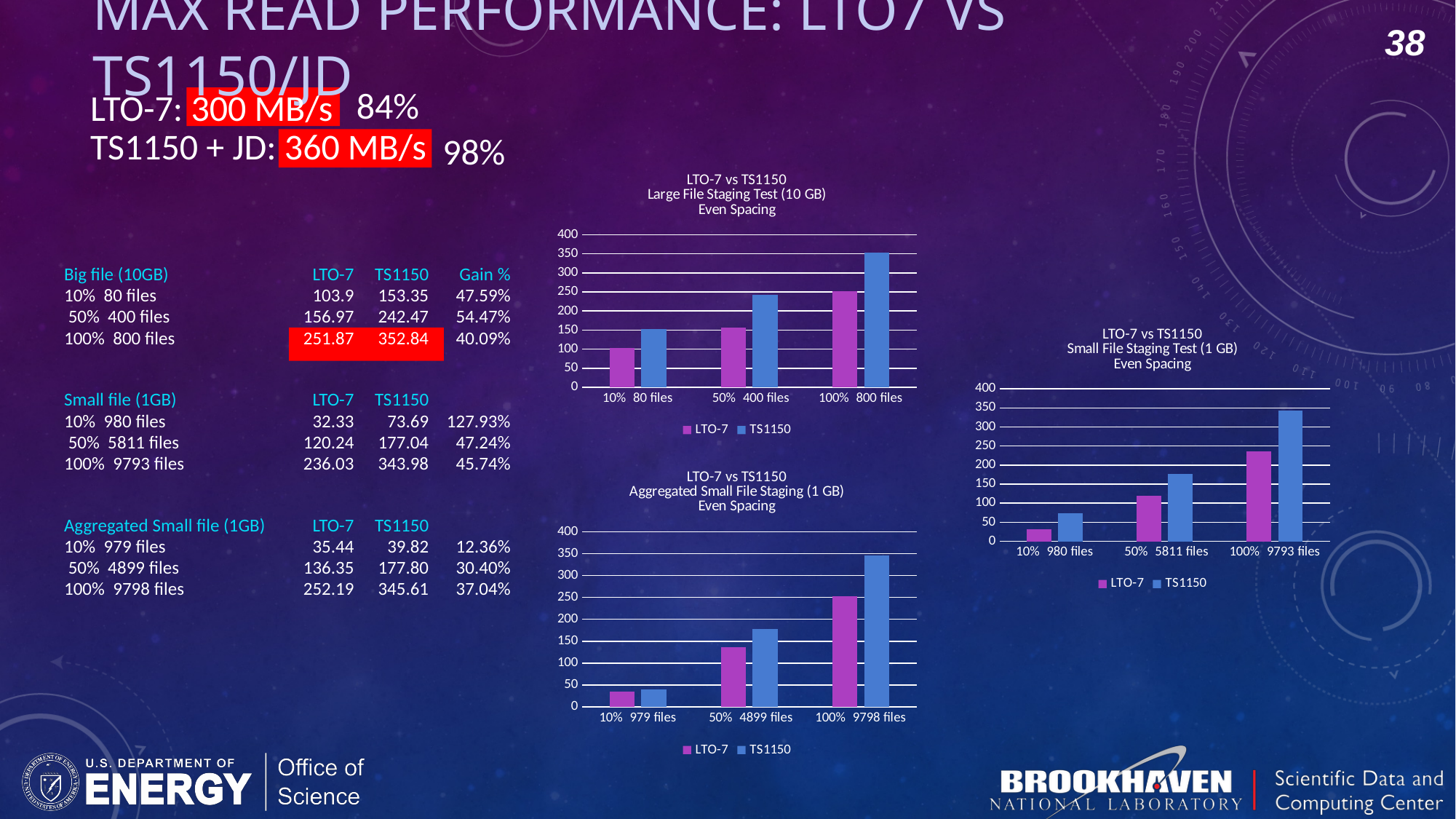
How many categories are shown on the x axis of the 'Aggregated Small File Staging (1 GB)' chart? 3 Using the table values on the slide, what is the difference between TS1150 and LTO-7 for '10% 980 files' in the 'Small File Staging Test (1 GB)' chart? 41.36 In the 'Large File Staging Test (10 GB)' chart, which category has the highest TS1150 value? 100% 800 files In the 'Large File Staging Test (10 GB)' chart, what colour are the LTO-7 bars? purple In the 'Large File Staging Test (10 GB)' chart, is the TS1150 value for '100% 800 files' greater or less than 300? greater According to the table on the slide, what is the TS1150 value for '50% 400 files' plotted in the 'Large File Staging Test (10 GB)' chart? 242.47 In the 'Small File Staging Test (1 GB)' chart, which series has the larger value for '100% 9793 files', LTO-7 or TS1150? TS1150 In the 'Aggregated Small File Staging (1 GB)' chart, which category has the lowest TS1150 value? 10% 979 files How many series does the legend of the 'Small File Staging Test (1 GB)' chart list? 2 What kind of chart is the 'LTO-7 vs TS1150 Large File Staging Test (10 GB)' chart? bar chart In the 'Aggregated Small File Staging (1 GB)' chart, is the LTO-7 value for '10% 979 files' greater or less than 50? less In the 'Small File Staging Test (1 GB)' chart, do the LTO-7 values rise or fall from left to right along the x axis? rise